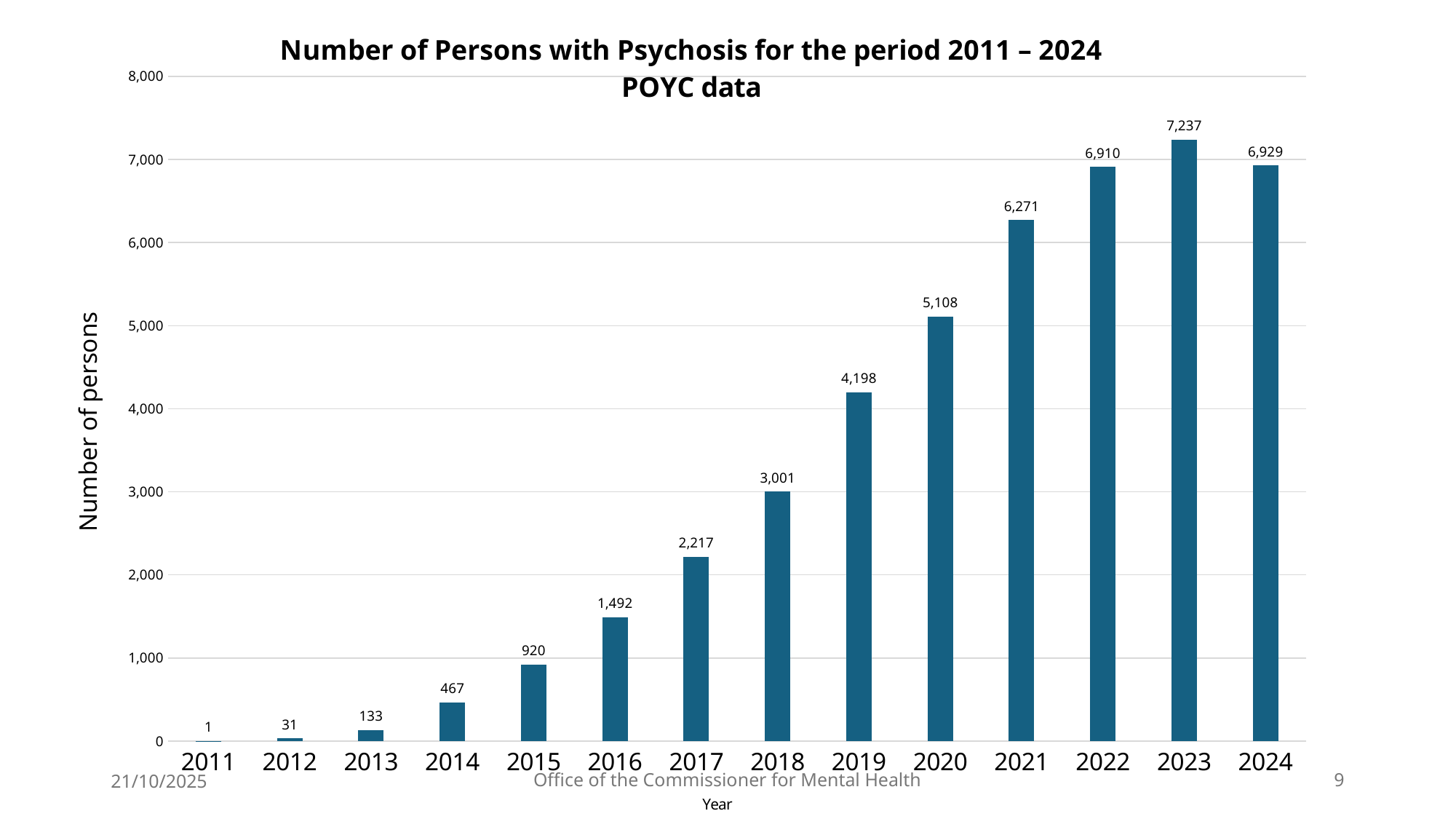
What is the difference between the number of persons in 2019 and in 2018? 1,197 What is the number of persons with psychosis in 2015? 920 Which year has more persons with psychosis, 2021 or 2024? 2024 What is the number of persons with psychosis in 2024? 6,929 What is the difference between the number of persons in 2023 and in 2022? 327 How many years are shown on the x axis? 14 Which year has the highest number of persons with psychosis? 2023 What is the number of persons with psychosis in 2020? 5,108 Is the value for 2017 greater or less than 2,000? greater What is the label of the vertical axis? Number of persons Which year has the lowest number of persons with psychosis? 2011 What kind of chart is shown on the slide? Bar chart